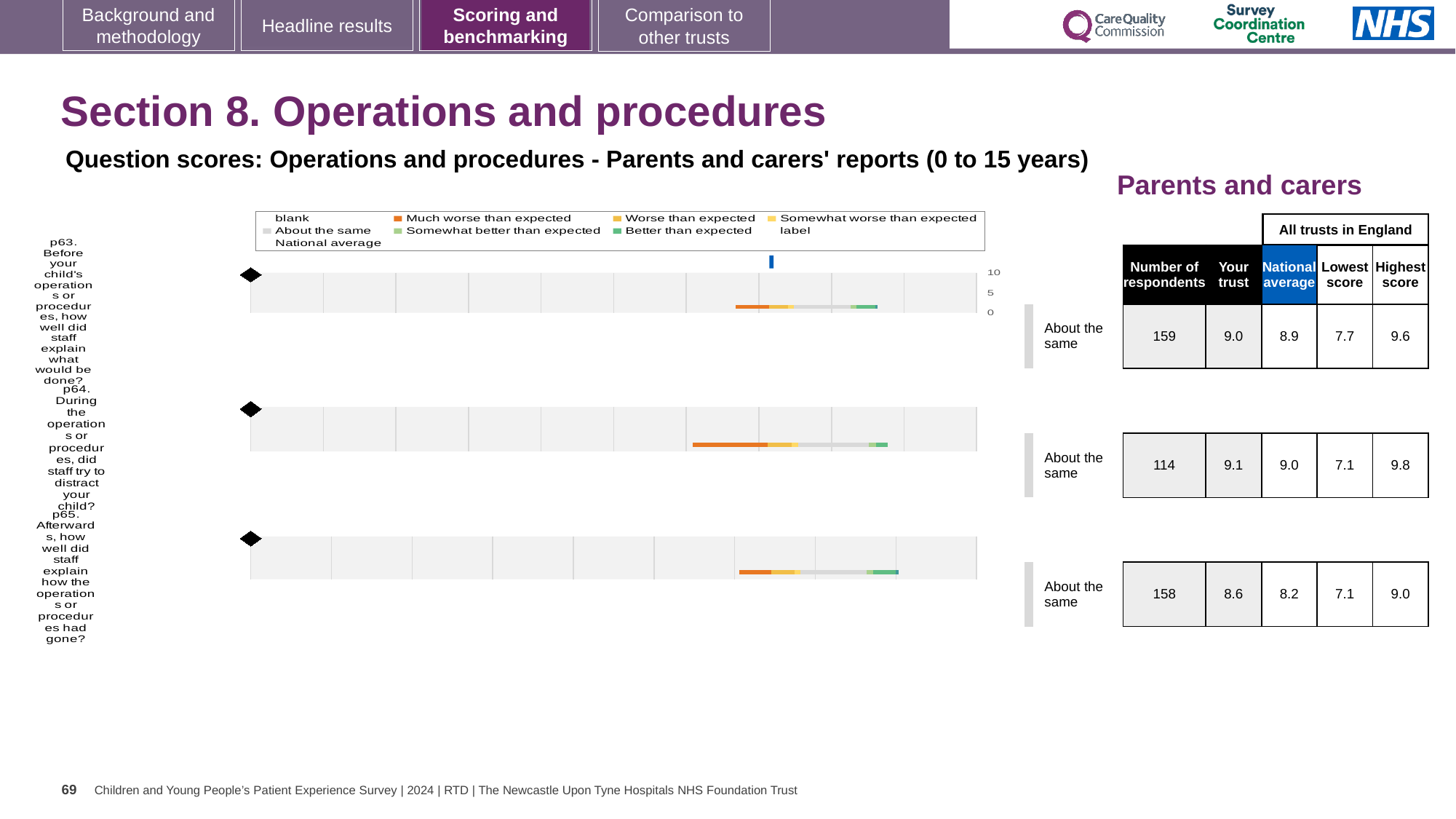
For p63, which is larger: the 'Your trust' score or the national average? Your trust How many respondents answered p65 (how well staff explained how the operation had gone)? 158 For p65, what is the difference between the 'Your trust' score and the national average? 0.4 What is the highest score among all trusts in England for p64? 9.8 Which question has the highest 'Your trust' score? p64 What is the 'Your trust' score for p63 (how well staff explained what would be done before the operation)? 9.0 Which question has the lowest 'Your trust' score? p65 What is the national average score for p64 (did staff try to distract your child during the operation)? 9.0 How many questions (p63, p64, p65) have a score chart on this slide? 3 What is the lowest score among all trusts in England for p63? 7.7 What kind of chart is used to show the question scores on this slide? bar chart What benchmark category is shown for p65? About the same